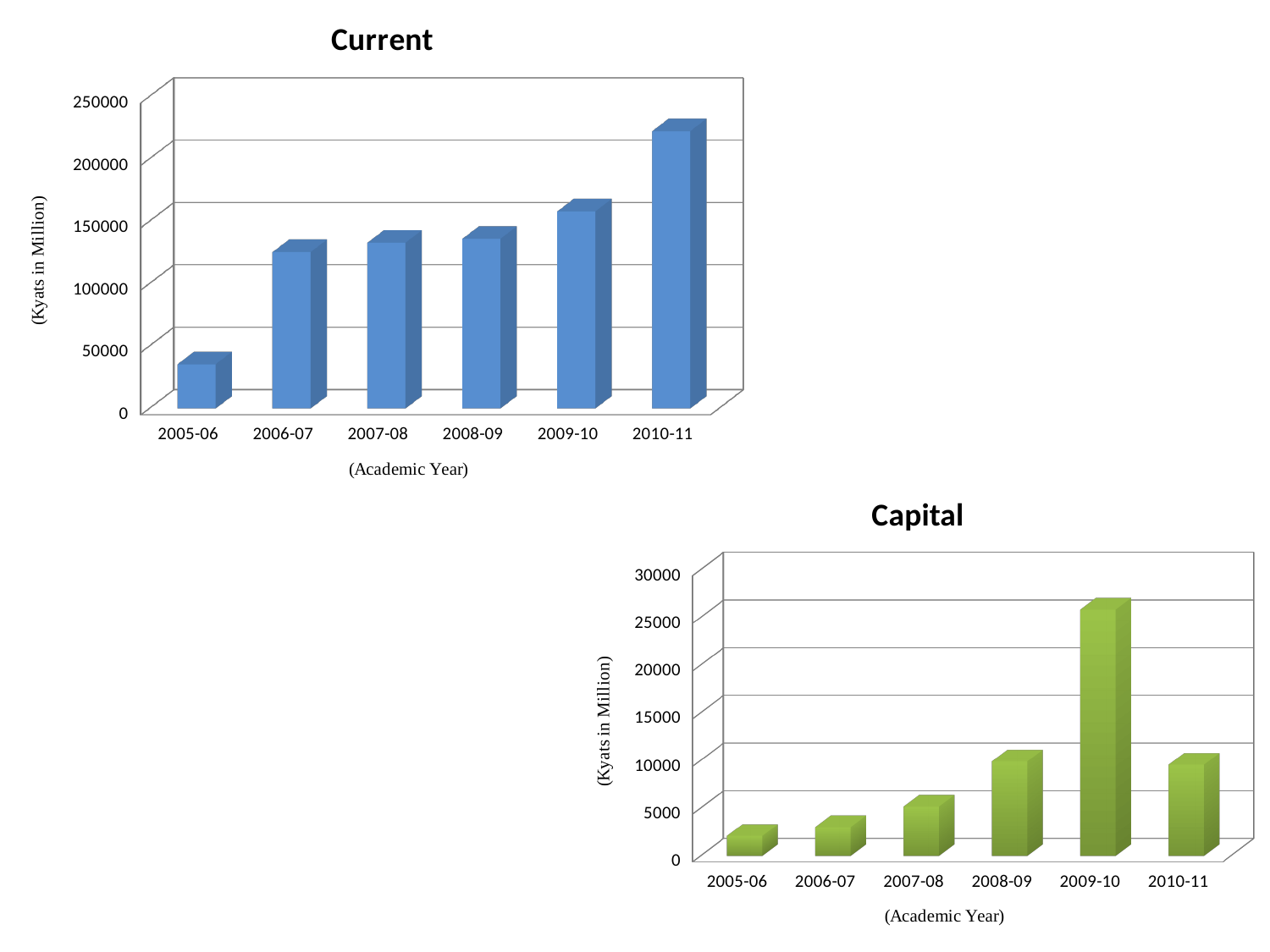
How many academic years are shown in the "Capital" chart? 6 In the "Current" chart, which academic year has the lowest value? 2005-06 In the "Current" chart, which academic year has the highest value? 2010-11 In the "Current" chart, do the values generally rise or fall from 2005-06 to 2010-11? rise In the "Capital" chart, which academic year has the highest value? 2009-10 In the "Current" chart, is the value for 2010-11 greater or less than 200000? greater In the "Current" chart, is the value for 2005-06 greater or less than 50000? less In the "Capital" chart, which academic year has the lowest value? 2005-06 In the "Capital" chart, is the value for 2009-10 greater or less than 20000? greater What type of chart is the "Current" chart? bar chart In the "Capital" chart, which is larger, the value for 2009-10 or the value for 2010-11? 2009-10 What is the y-axis label of the "Capital" chart? (Kyats in Million)